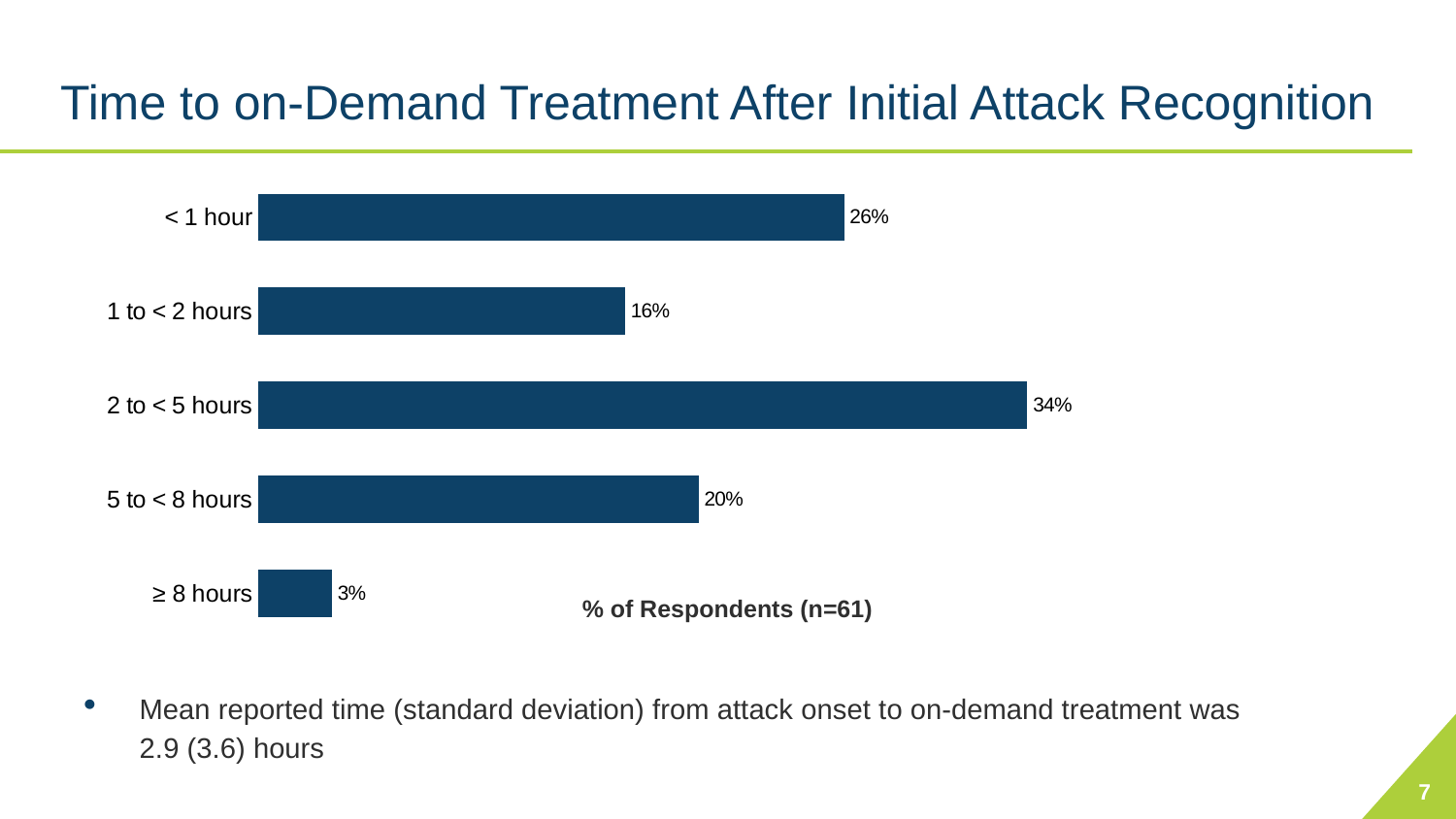
What percentage of respondents reported a time of ≥ 8 hours? 3% How many time categories are shown in the chart? 5 What is the title of the chart on the slide? Time to on-Demand Treatment After Initial Attack Recognition What is the difference in percentage points between the 2 to < 5 hours category and the < 1 hour category? 8 Which time category has the highest percentage of respondents? 2 to < 5 hours What percentage of respondents reported a time of 5 to < 8 hours? 20% What percentage of respondents reported a time of 1 to < 2 hours? 16% Which time category has the lowest percentage of respondents? ≥ 8 hours What percentage of respondents reported a time to on-demand treatment of < 1 hour? 26% How many respondents (n) does the chart's axis label indicate? 61 Which category has a larger percentage of respondents: 1 to < 2 hours or 5 to < 8 hours? 5 to < 8 hours What type of chart is shown on the slide? Bar chart